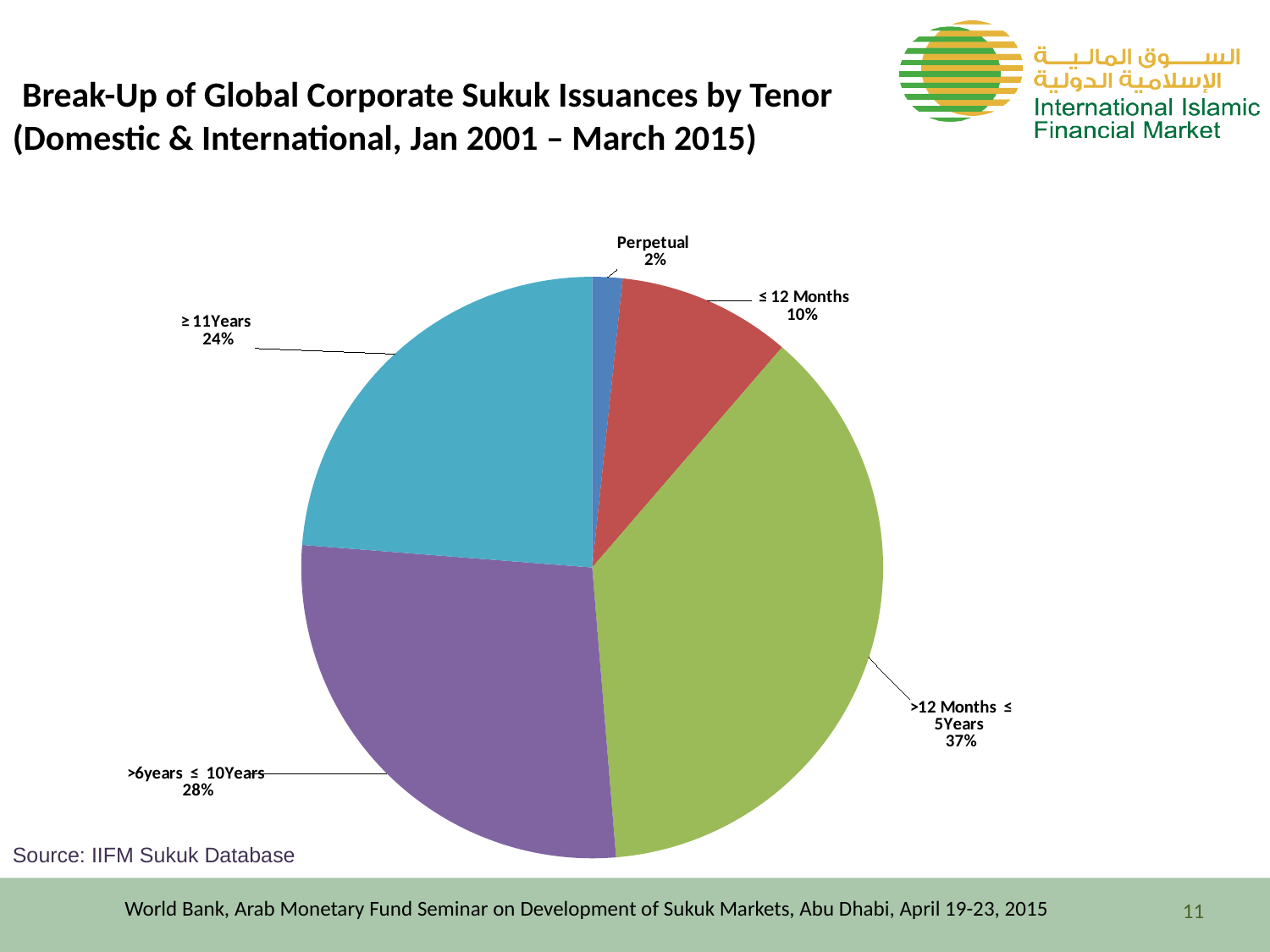
What is the difference in percentage points between the >6years ≤ 10Years slice and the ≥ 11Years slice? 4 percentage points Which is larger: the share for ≤ 12 Months or the share for ≥ 11Years? ≥ 11Years What share of issuances is Perpetual? 2% How many tenor categories are shown in the pie chart? 5 Which tenor category has the largest share of issuances? >12 Months ≤ 5Years What share of issuances has a tenor of ≤ 12 Months? 10% What kind of chart is shown on the slide? Pie chart What share of global corporate sukuk issuances has a tenor of >12 Months ≤ 5Years? 37% Which tenor category has the smallest share of issuances? Perpetual What is the source cited for the chart data? IIFM Sukuk Database What is the combined share of the >12 Months ≤ 5Years and >6years ≤ 10Years slices? 65% What share of issuances has a tenor of ≥ 11Years? 24%